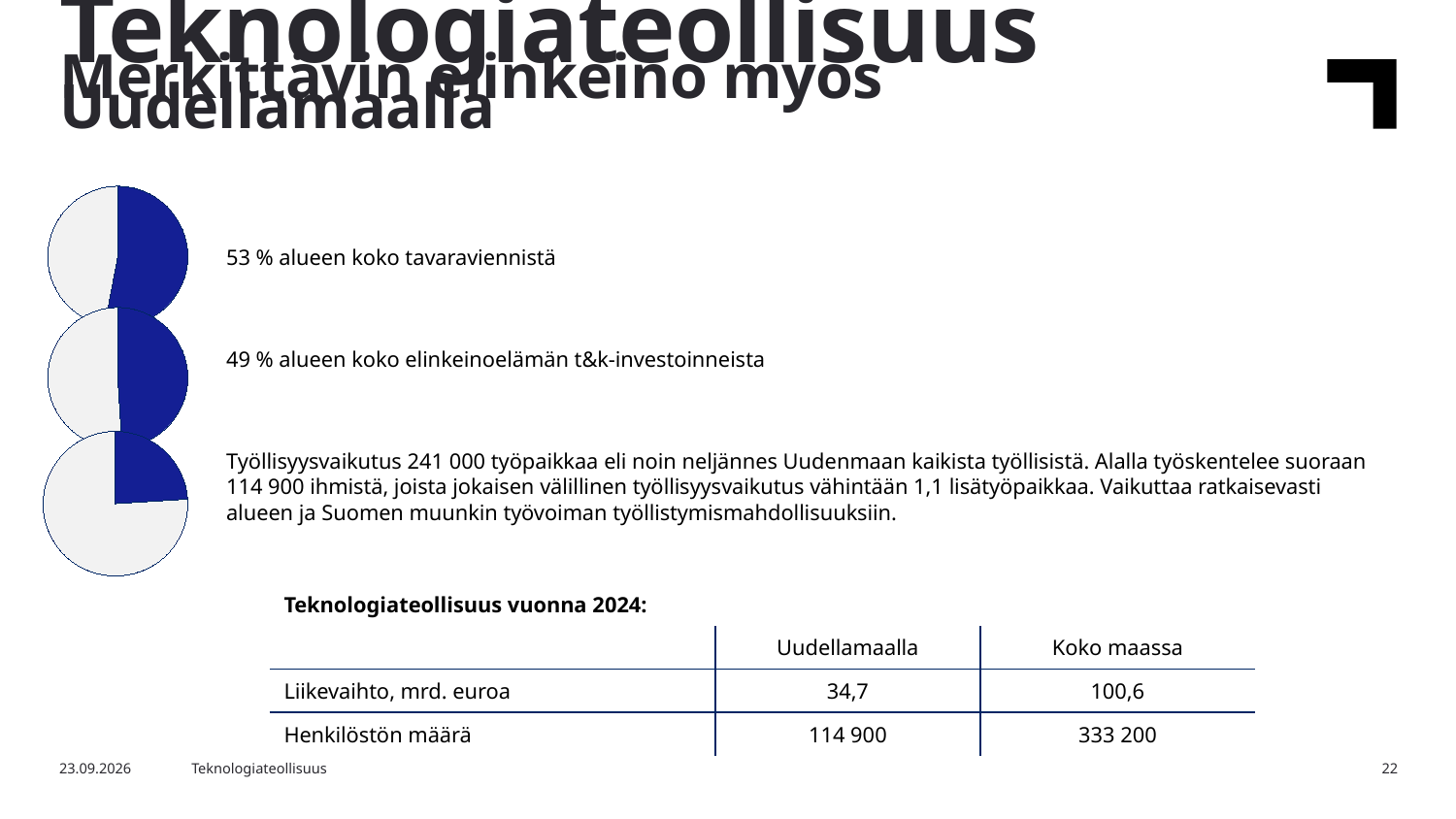
What is the difference between the share shown for the top pie chart (53 %) and the middle pie chart (49 %)? 4 percentage points Which pie chart has the larger highlighted slice, the top one (goods exports) or the middle one (R&D investments)? The top one (goods exports) How many pie charts are on the slide? 3 Which of the three pie charts has the largest highlighted slice? The top one (goods exports) What does the top pie chart represent, according to the text next to it? 53 % alueen koko tavaraviennistä What kind of charts are shown on the left side of the slide? Pie charts In the top pie chart, what share of the region's total goods exports does the highlighted slice represent? 53 % In the middle pie chart, what share of the region's business R&D investments does the highlighted slice represent? 49 % Which of the three pie charts has the smallest highlighted slice? The bottom one (employment effect) What colour is used for the highlighted slice in the pie charts? Dark blue